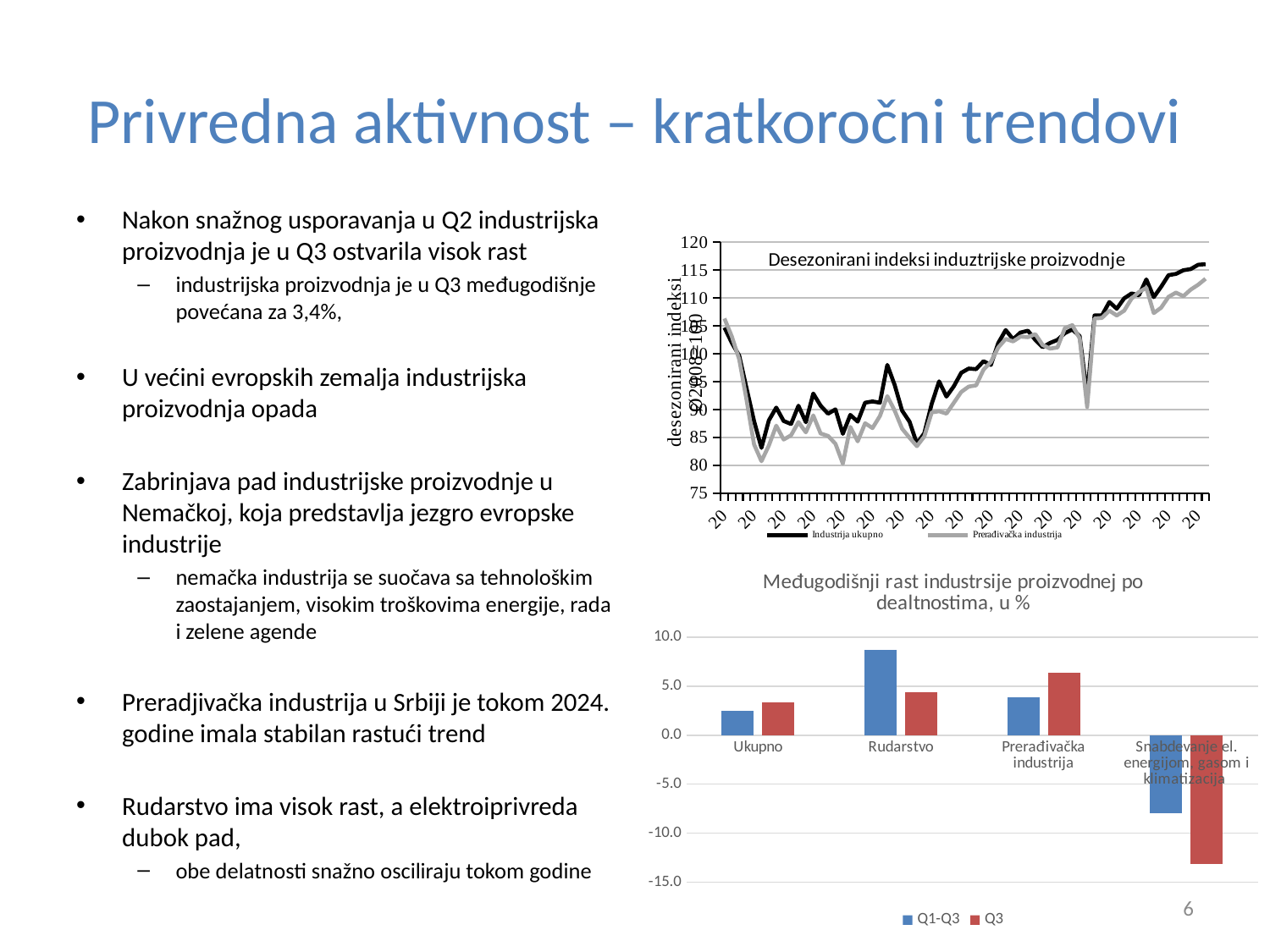
What kind of chart is the top chart titled 'Desezonirani indeksi induztrijske proizvodnje'? line chart In the bottom bar chart, is the Q1-Q3 value for Rudarstvo greater or less than 5.0? greater In the bottom bar chart, is the Q3 value for Snabdevanje el. energijom, gasom i klimatizacija greater or less than -10.0? less In the bottom bar chart, which category has the highest Q1-Q3 value? Rudarstvo In the bottom bar chart, which is larger for Rudarstvo: the Q1-Q3 value or the Q3 value? Q1-Q3 In the top line chart, does the 'Industrija ukupno' series overall rise or fall from the left to the right end of the x axis? rise In the bottom bar chart, which is larger for Prerađivačka industrija: the Q1-Q3 value or the Q3 value? Q3 In the bottom bar chart, how many categories are shown on the x axis? 4 In the bottom bar chart, how many series does the legend list? 2 In the bottom bar chart, which category has the lowest Q3 value? Snabdevanje el. energijom, gasom i klimatizacija In the top line chart, how many series does the legend list? 2 What kind of chart is the bottom chart titled 'Međugodišnji rast industrsije proizvodnej po dealtnostima, u %'? bar chart